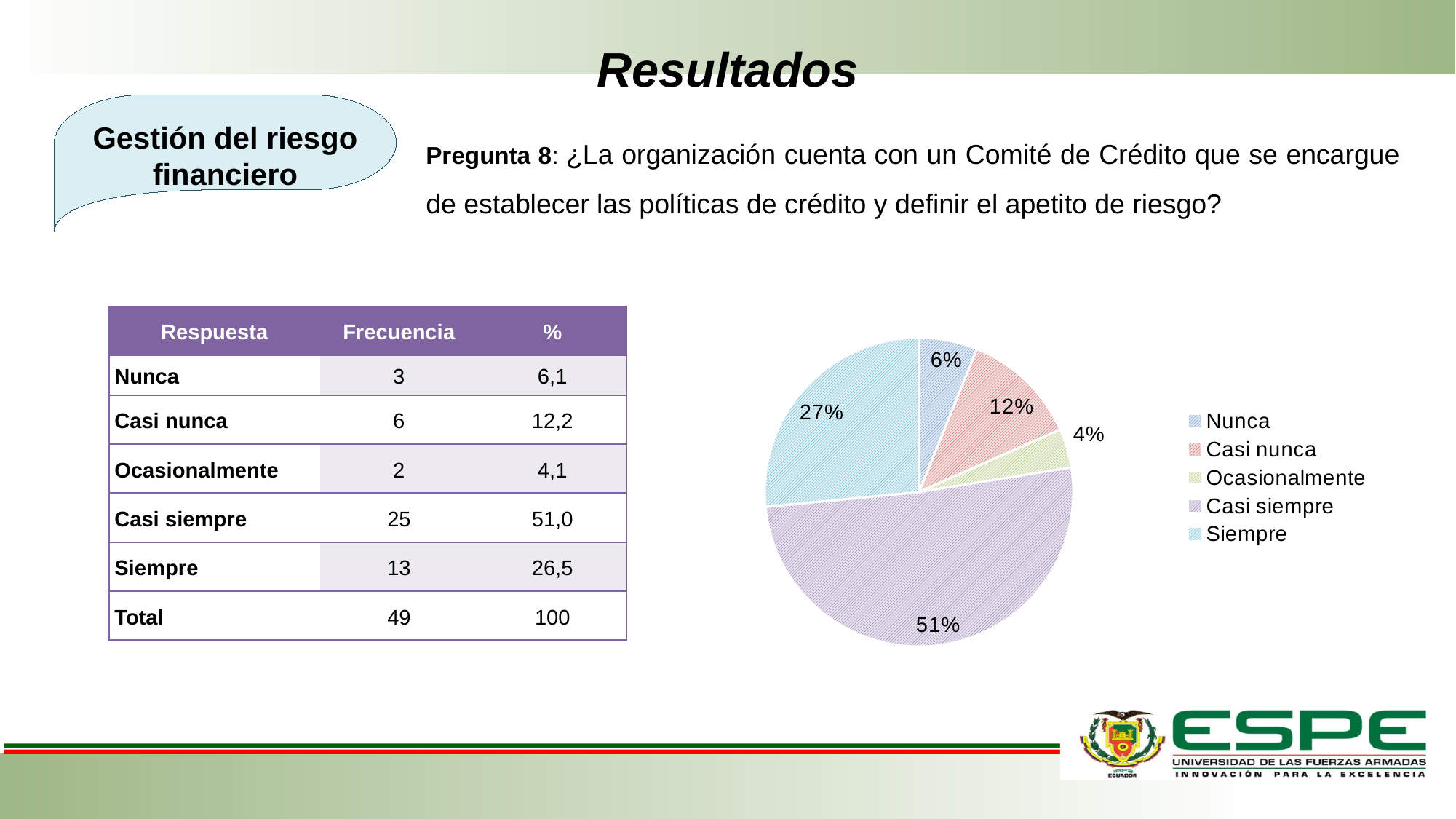
What share of the pie does the Ocasionalmente slice represent? 4% What share of the pie does the Nunca slice represent? 6% Which slice is larger, Siempre or Casi nunca? Siempre What type of chart is shown on the slide? pie chart Which legend entry is listed first in the pie chart legend? Nunca Which category has the smallest slice of the pie? Ocasionalmente What share of the pie does the Casi siempre slice represent? 51% What is the difference in percentage points between the Casi siempre slice and the Siempre slice? 24% Which category has the largest slice of the pie? Casi siempre How many categories does the pie chart legend list? 5